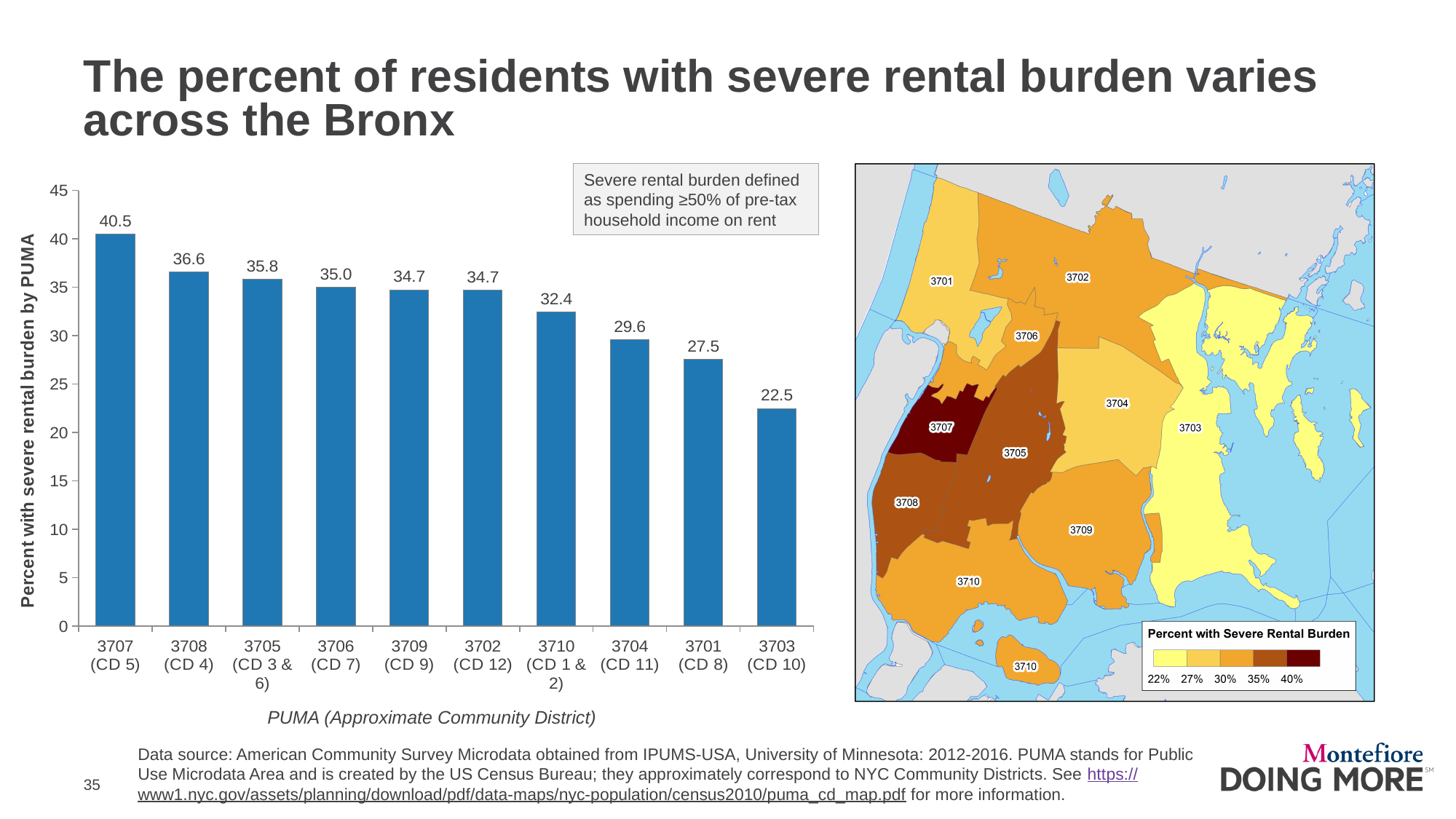
What is the difference in percent with severe rental burden between PUMA 3707 (CD 5) and PUMA 3703 (CD 10)? 18.0 Is the value for PUMA 3706 (CD 7) greater or less than 30? greater How many PUMAs are shown in the bar chart? 10 What type of chart is used to show the percent with severe rental burden by PUMA? Bar chart Do the values in the bar chart rise or fall from left to right along the x axis? Fall Which has a higher percent with severe rental burden, PUMA 3701 (CD 8) or PUMA 3704 (CD 11)? 3704 (CD 11) Which PUMA has the highest percent with severe rental burden? 3707 (CD 5) What is the percent with severe rental burden for PUMA 3707 (CD 5)? 40.5 What is the percent with severe rental burden for PUMA 3703 (CD 10)? 22.5 What is the percent with severe rental burden for PUMA 3710 (CD 1 & 2)? 32.4 What is the difference in percent with severe rental burden between PUMA 3708 (CD 4) and PUMA 3704 (CD 11)? 7.0 Which PUMA has the lowest percent with severe rental burden? 3703 (CD 10)